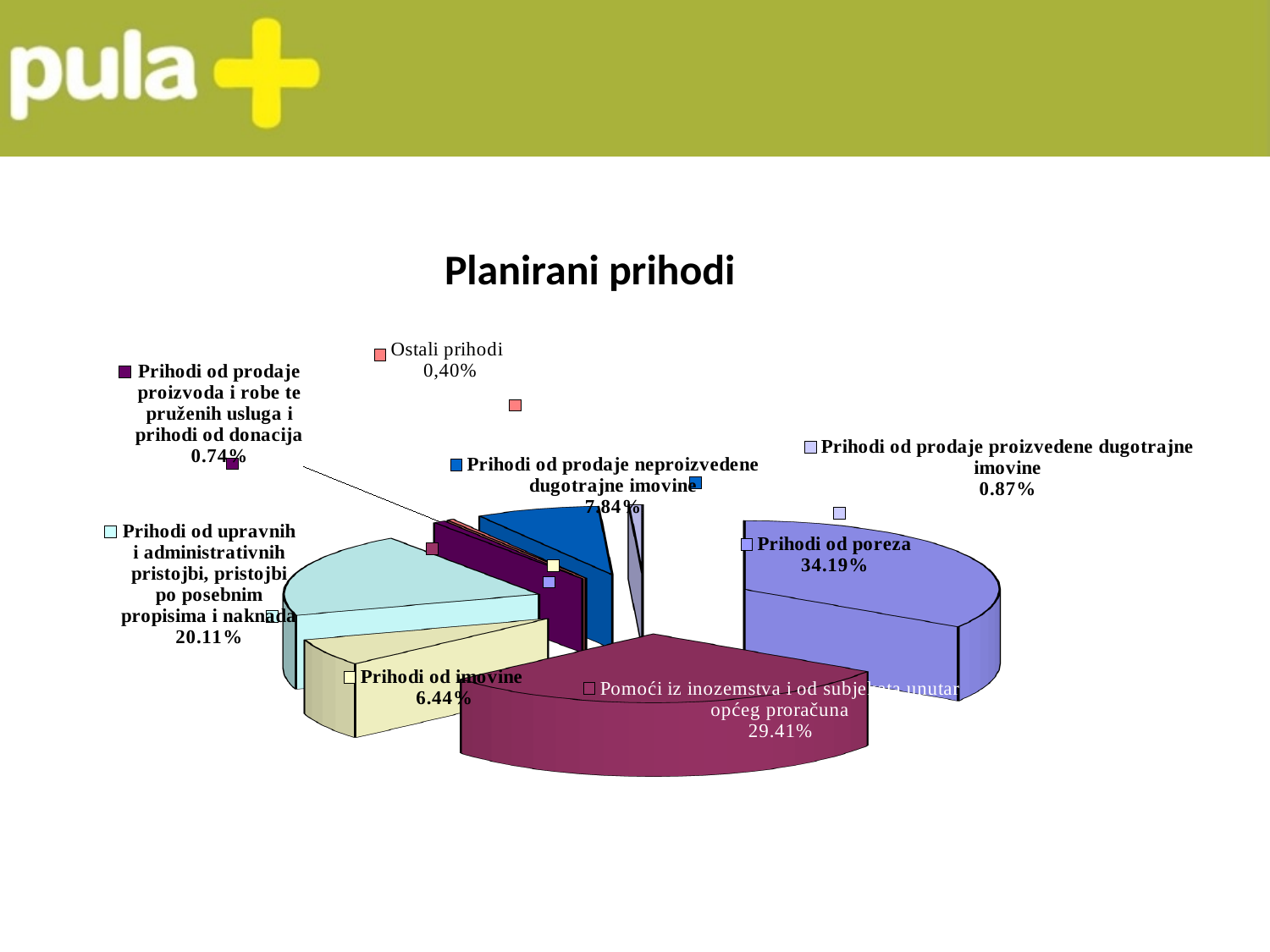
What percentage is shown for Pomoći iz inozemstva i od subjekata unutar općeg proračuna? 29.41% What kind of chart is shown on the slide? Pie chart What percentage is shown for Prihodi od prodaje neproizvedene dugotrajne imovine? 7.84% Which category has the largest share of the pie? Prihodi od poreza Which category has the smallest share of the pie? Ostali prihodi What is the difference in percentage points between Prihodi od poreza and Pomoći iz inozemstva i od subjekata unutar općeg proračuna? 4.78 What share of the pie is labelled for Prihodi od poreza? 34.19% How many slices does the pie chart have? 8 Which is larger: Prihodi od imovine or Prihodi od prodaje neproizvedene dugotrajne imovine? Prihodi od prodaje neproizvedene dugotrajne imovine What percentage is shown for Prihodi od imovine? 6.44% What percentage is shown for Ostali prihodi? 0,40% What is the title of the chart? Planirani prihodi